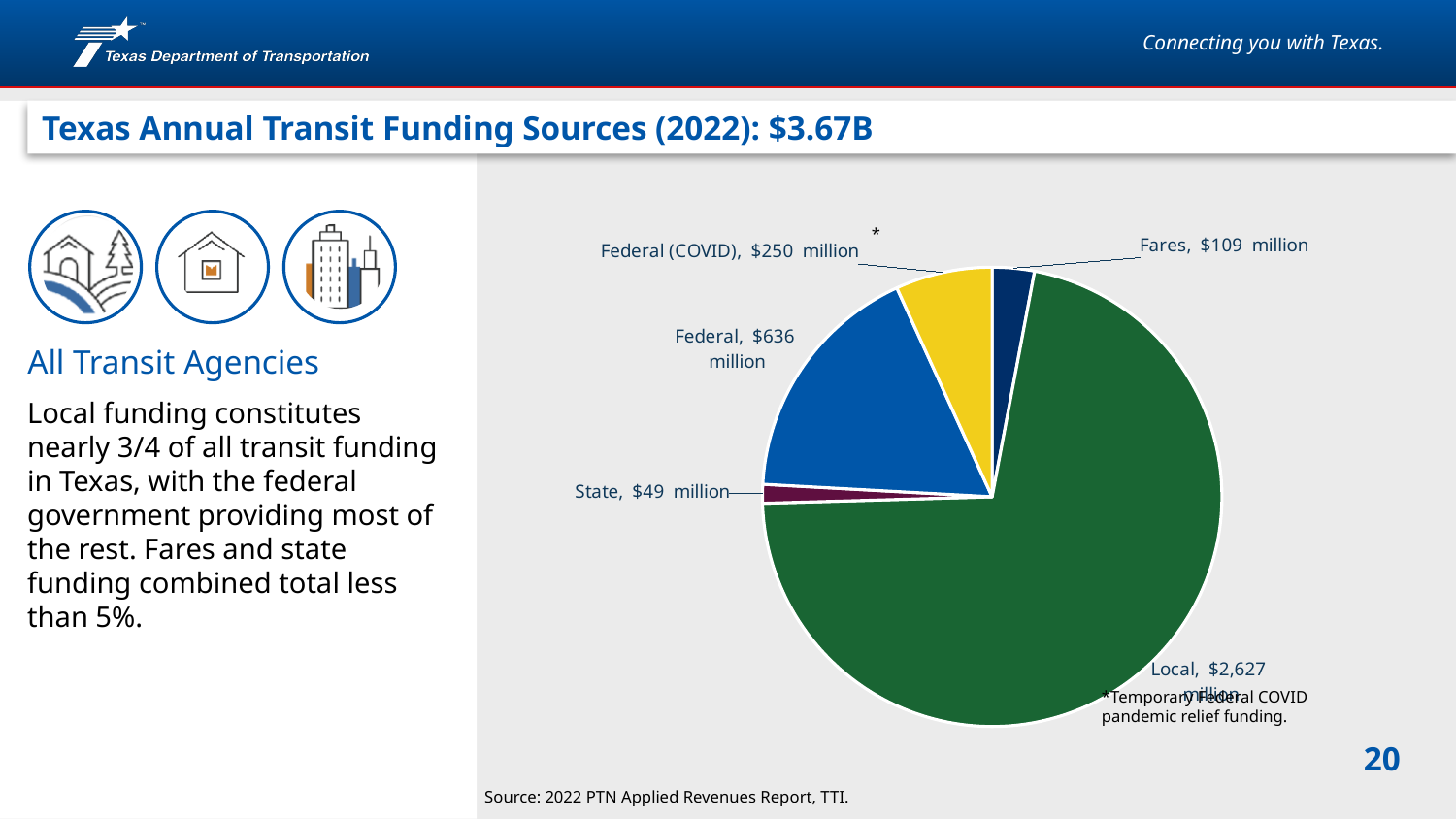
Which funding source has the largest slice of the pie chart? Local What is the value for Federal (COVID) funding in the pie chart? $250 million What is the value for Fares in the pie chart? $109 million Which is larger, Federal funding or Federal (COVID) funding? Federal What is the difference between Fares and State funding? $60 million How many funding sources (slices) are shown in the pie chart? 5 What is the value for Local funding in the pie chart? $2,627 million What kind of chart is shown on the slide? Pie chart What does the asterisk next to Federal (COVID) denote, according to the chart footnote? Temporary Federal COVID pandemic relief funding Which funding source has the smallest slice of the pie chart? State What is the value for Federal funding (excluding COVID) in the pie chart? $636 million What is the difference between Federal funding and Federal (COVID) funding? $386 million